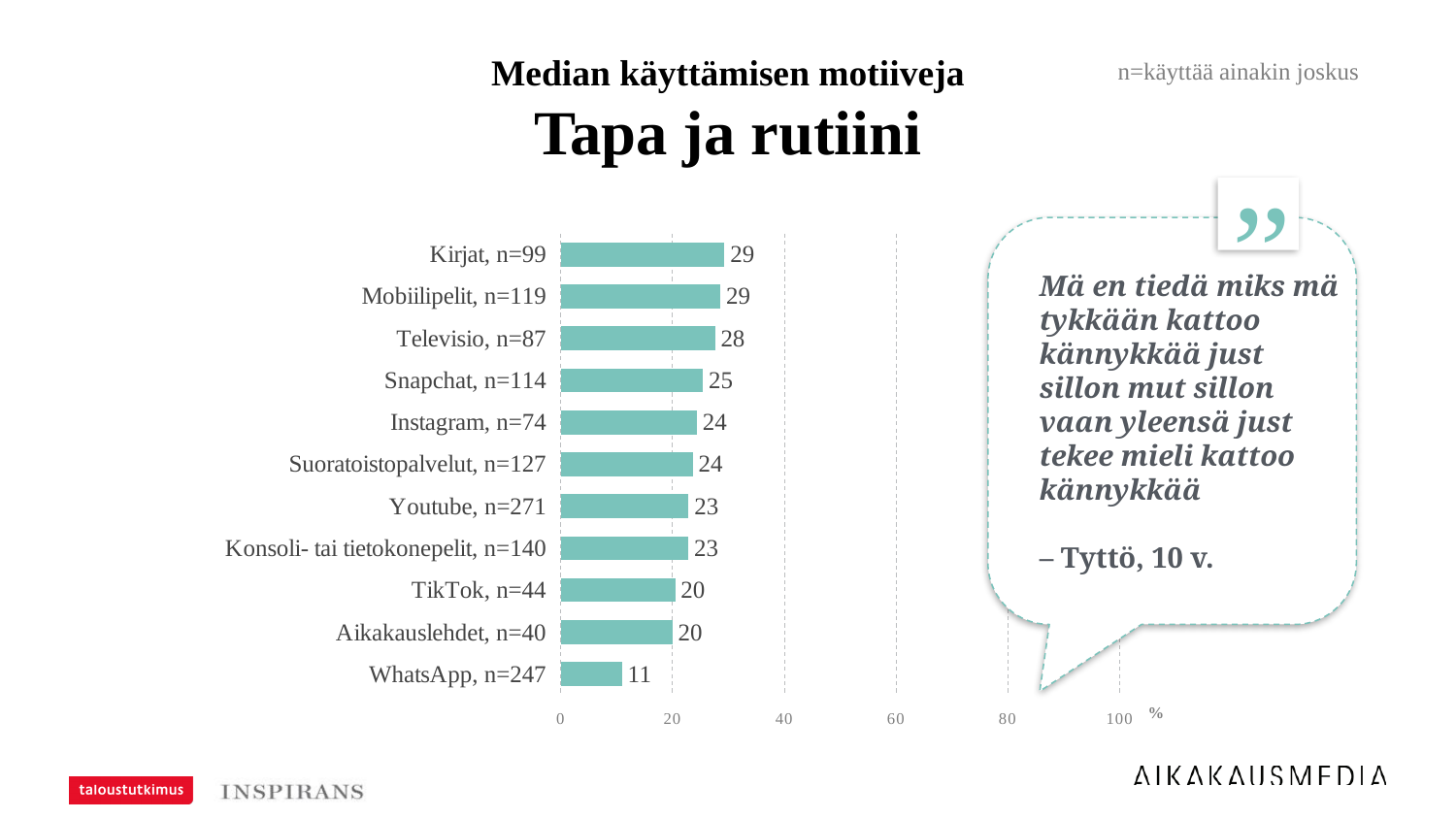
What is the difference between the values for Kirjat, n=99 and WhatsApp, n=247? 18 What is the value for Televisio, n=87? 28 What is the difference between the values for Televisio, n=87 and TikTok, n=44? 8 Is the value for Mobiilipelit, n=119 greater or less than 20? greater What is the main title of the chart? Tapa ja rutiini What kind of chart is shown on the slide? Bar chart What is the value for WhatsApp, n=247? 11 How many categories are shown in the chart? 11 Which is larger, the value for Instagram, n=74 or the value for Aikakauslehdet, n=40? Instagram, n=74 What is the value for Snapchat, n=114? 25 Which category has the lowest value? WhatsApp, n=247 Is the value for WhatsApp, n=247 greater or less than 20? less